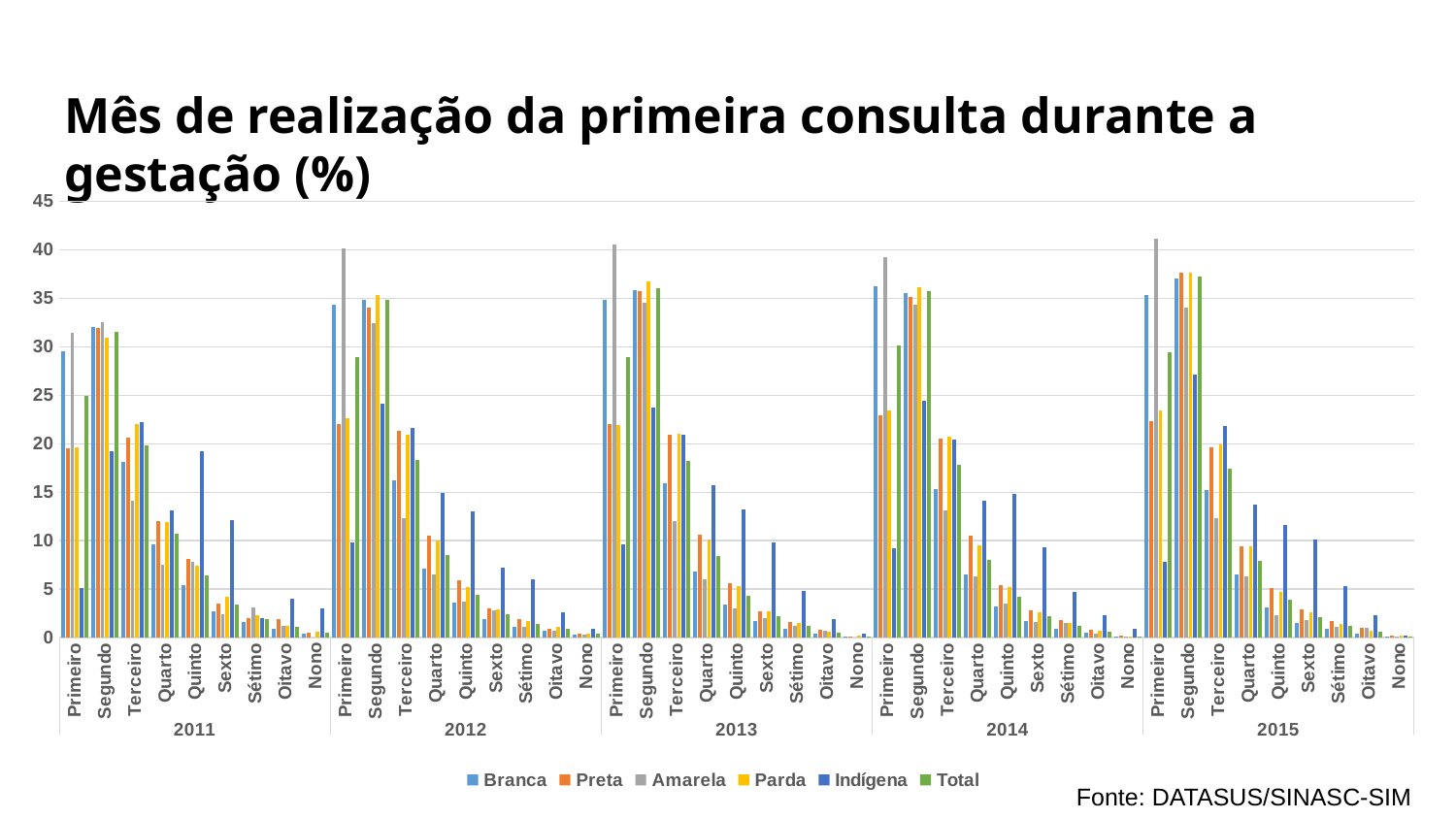
Which series has the highest bar for Primeiro in 2015? Amarela How many series does the legend list? 6 Is the value for Amarela in Primeiro 2015 greater or less than 40? greater How many month categories (Primeiro to Nono) are shown within each year? 9 Within each year, do the Total values generally rise or fall from Primeiro to Nono? fall What kind of chart is shown on the slide? bar chart In Quinto 2011, which is larger: the value for Indígena or the value for Branca? Indígena Is the value for Total in Primeiro 2012 greater or less than 30? less Is the value for Indígena in Quinto 2011 greater or less than 20? less What is the source cited for the chart data? DATASUS/SINASC-SIM Which series has the lowest bar for Primeiro in 2011? Indígena How many years are shown along the x axis? 5